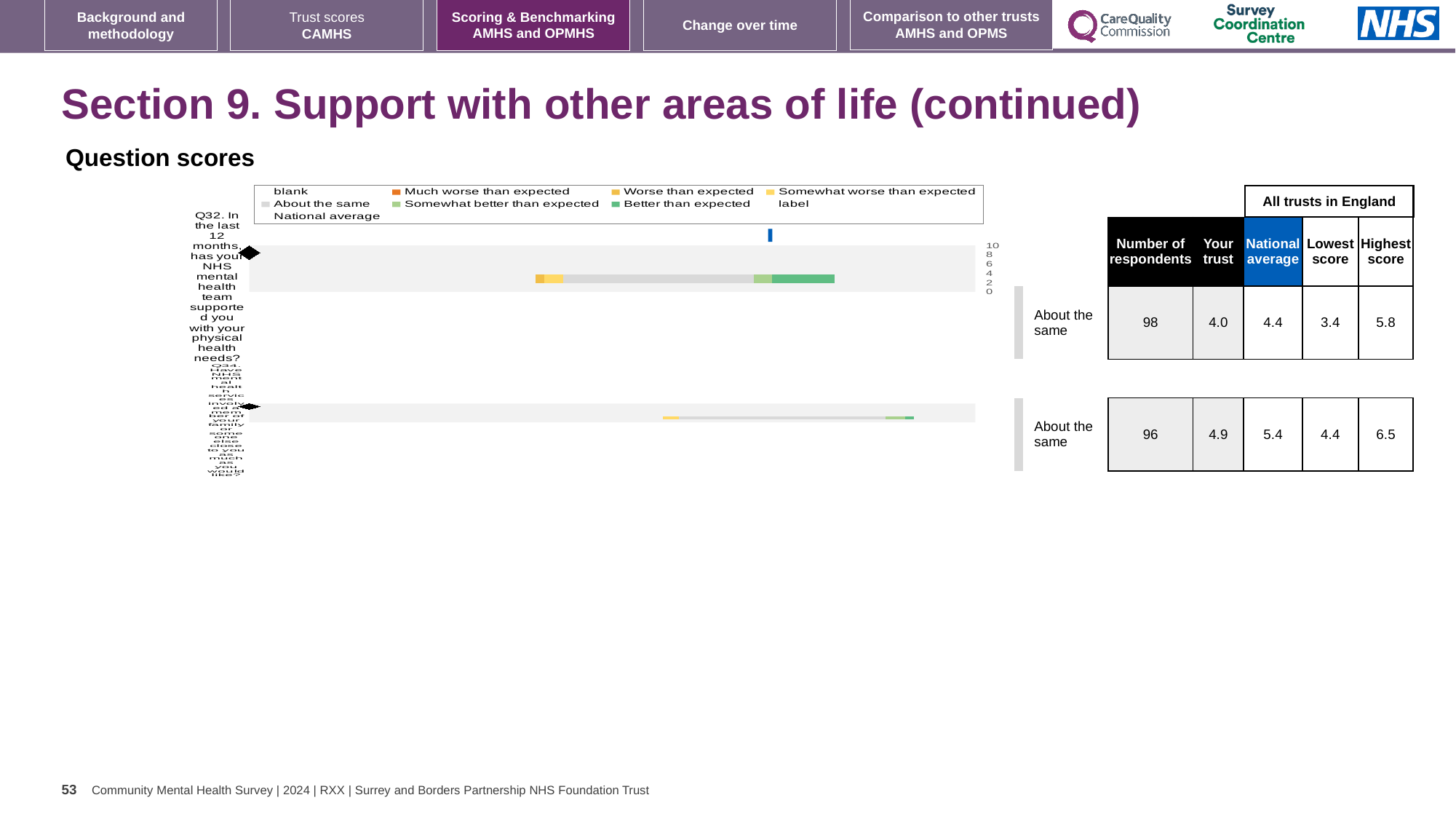
Which question has the higher 'Your trust' score in the table, Q32 or Q34? Q34 In the table beside the chart, how many respondents answered Q34? 96 For Q32, is the 'Your trust' score higher or lower than the national average in the table? lower In the table beside the chart, what is the highest score for Q32? 5.8 In the table beside the chart, what is the national average for Q34? 5.4 In the table beside the chart, what is the 'Your trust' score for Q32? 4.0 What kind of chart is shown under 'Question scores'? bar chart What colour represents 'Better than expected' in the chart legend? green How many question bars are plotted in the chart? 2 What is the highest tick value shown on the chart's axis? 10 What benchmark category is shown next to both Q32 and Q34? About the same What is the difference between the highest score and the lowest score for Q34 in the table? 2.1